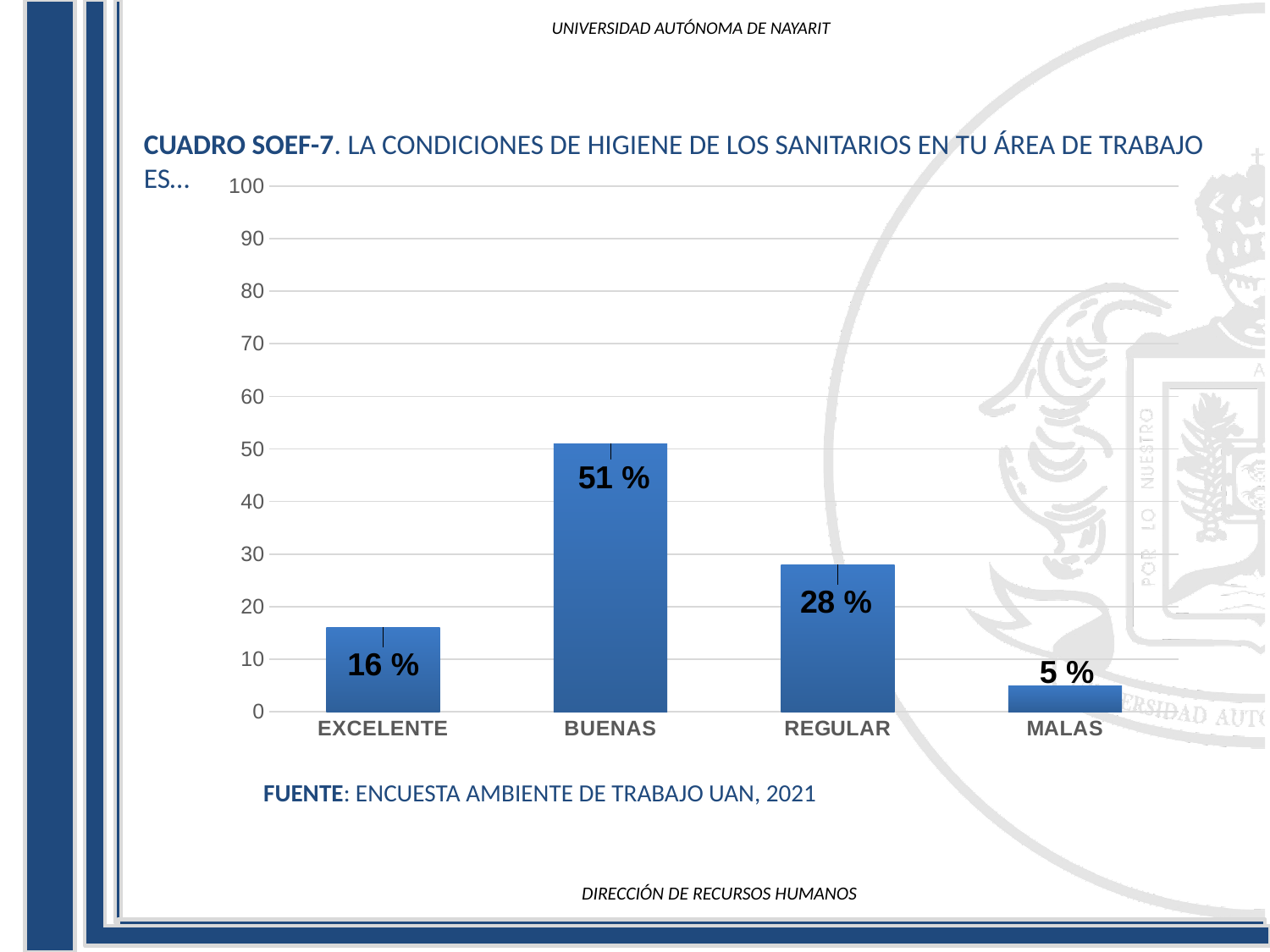
What source is cited below the chart? ENCUESTA AMBIENTE DE TRABAJO UAN, 2021 What is the value for REGULAR? 28 % Which category has the highest value? BUENAS What is the value for MALAS? 5 % What kind of chart is shown on the slide? bar chart Which category has the lowest value? MALAS How many categories are shown on the x axis? 4 What is the value for EXCELENTE? 16 % Is the value for BUENAS greater or less than 50? greater What is the difference between the values for BUENAS and REGULAR? 23 % What is the value for BUENAS? 51 % Which is larger, the value for EXCELENTE or the value for REGULAR? REGULAR